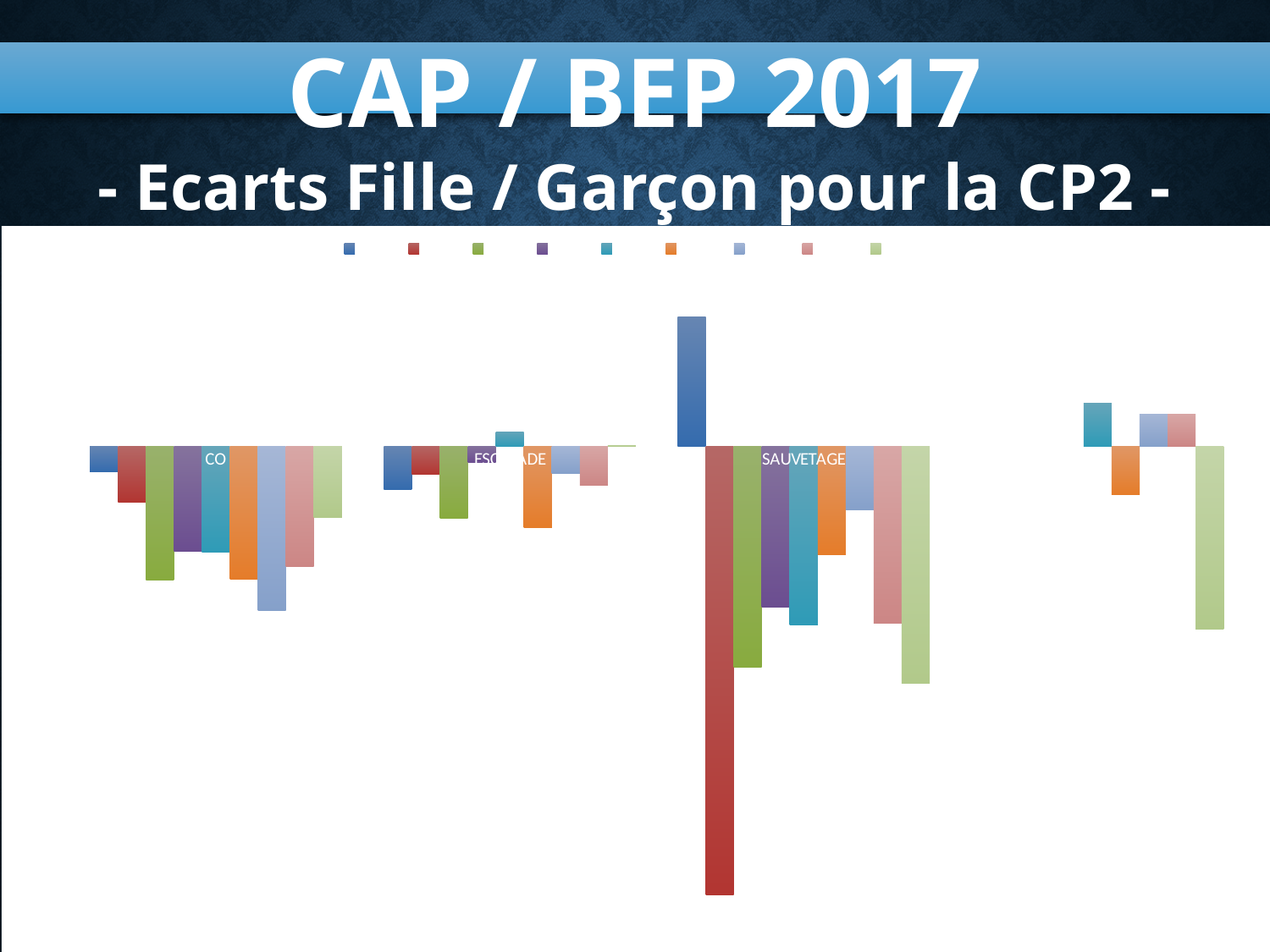
Which category contains the bar that extends furthest below the axis? SAUVETAGE How many series does the legend list? 9 How many bars are plotted in the rightmost group? 5 How many category groups of bars are plotted on the chart? 4 What colour is the bar that extends furthest below the axis? red What kind of chart is shown on the slide? bar chart What is the title of the slide? CAP / BEP 2017 - Ecarts Fille / Garçon pour la CP2 - How many bars are plotted in the SAUVETAGE group? 9 Which category contains the tallest bar above the axis? SAUVETAGE In the SAUVETAGE group, which extends further from the axis: the blue bar above it or the red bar below it? the red bar below